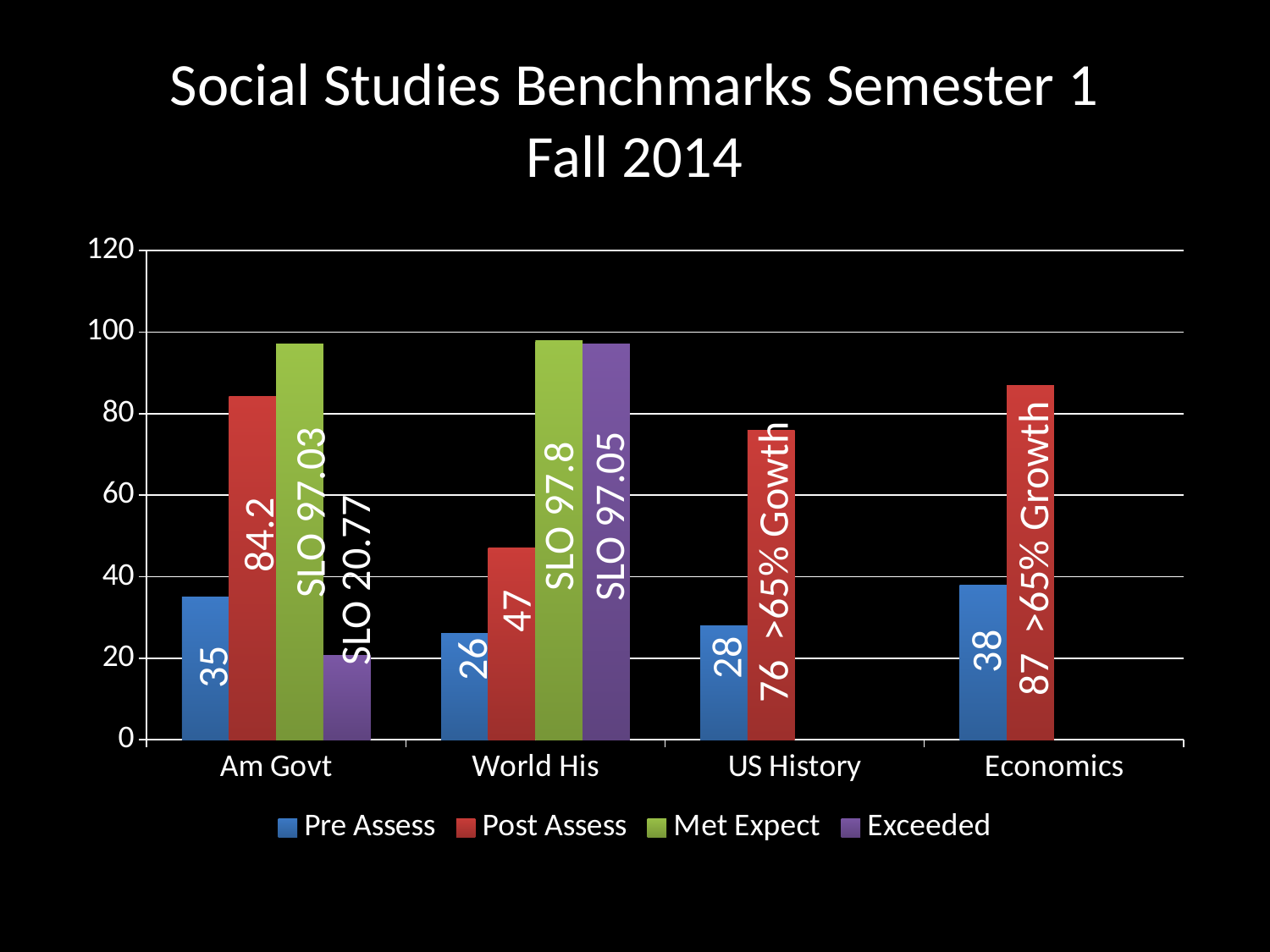
Is the Met Expect value for World His greater or less than 80? greater What is the Post Assess value for Am Govt? 84.2 Which category has the lowest Pre Assess value? World His What is the Post Assess value for World His? 47 What kind of chart is shown on the slide? Bar chart What is the Pre Assess value for Am Govt? 35 How many series does the legend list? 4 What is the Pre Assess value for Economics? 38 How many categories are shown on the x axis? 4 Which category has the highest Pre Assess value? Economics Which is larger, the Post Assess value for US History or the Post Assess value for Economics? Economics What is the difference between the Post Assess and Pre Assess values for Economics? 49